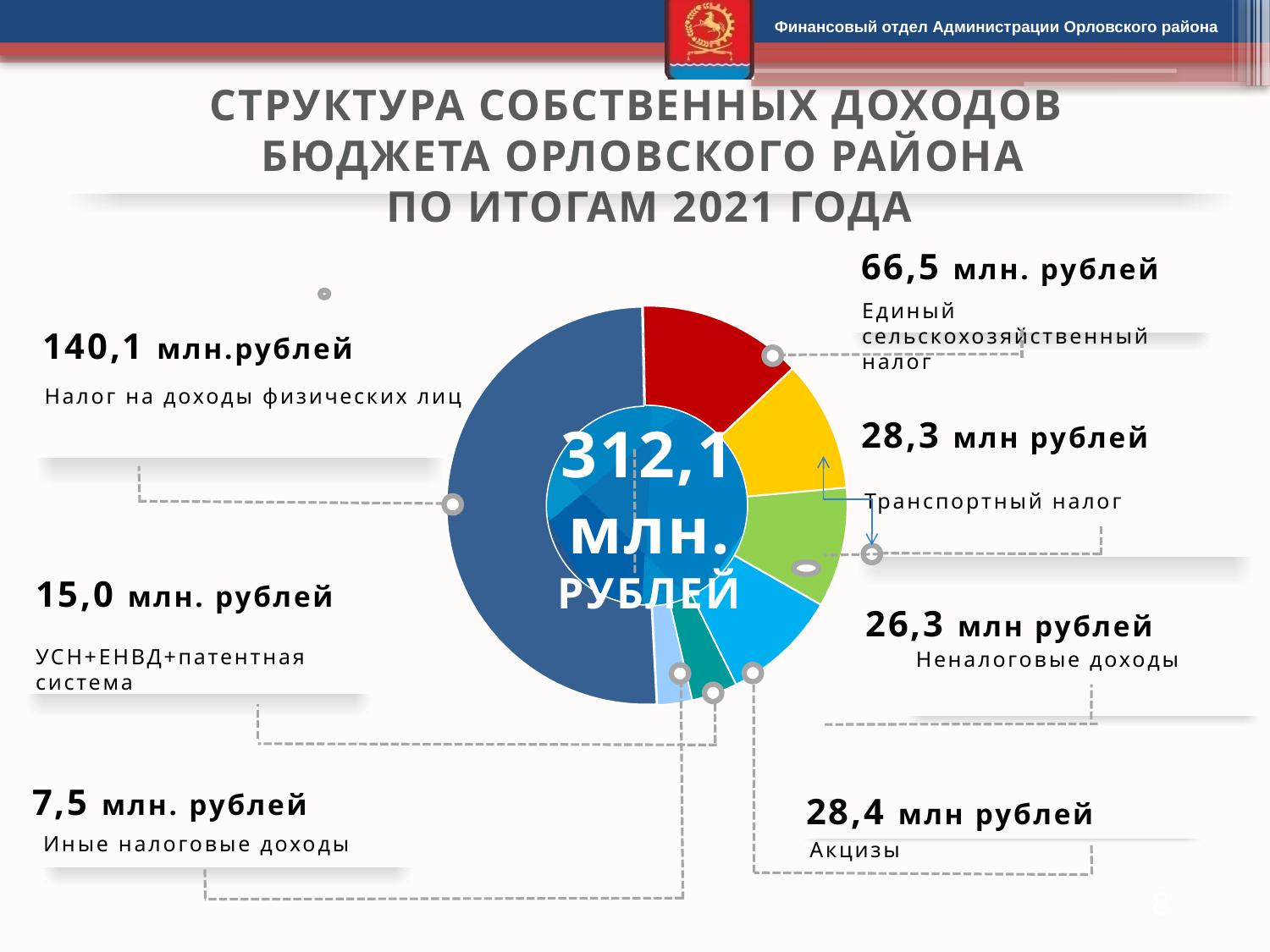
What is the value for Иные налоговые доходы? 7,5 млн. рублей What total is shown in the centre of the chart? 312,1 млн. рублей What is the difference between Налог на доходы физических лиц and Единый сельскохозяйственный налог? 73,6 млн. рублей Which category has the smallest value? Иные налоговые доходы What is the value for Акцизы? 28,4 млн рублей What kind of chart is shown on the slide? Donut (pie) chart Which is larger: Неналоговые доходы or УСН+ЕНВД+патентная система? Неналоговые доходы What is the value for Транспортный налог? 28,3 млн рублей How many categories does the chart show? 7 What is the value for Налог на доходы физических лиц? 140,1 млн.рублей Which category has the largest value? Налог на доходы физических лиц What is the value for Единый сельскохозяйственный налог? 66,5 млн. рублей